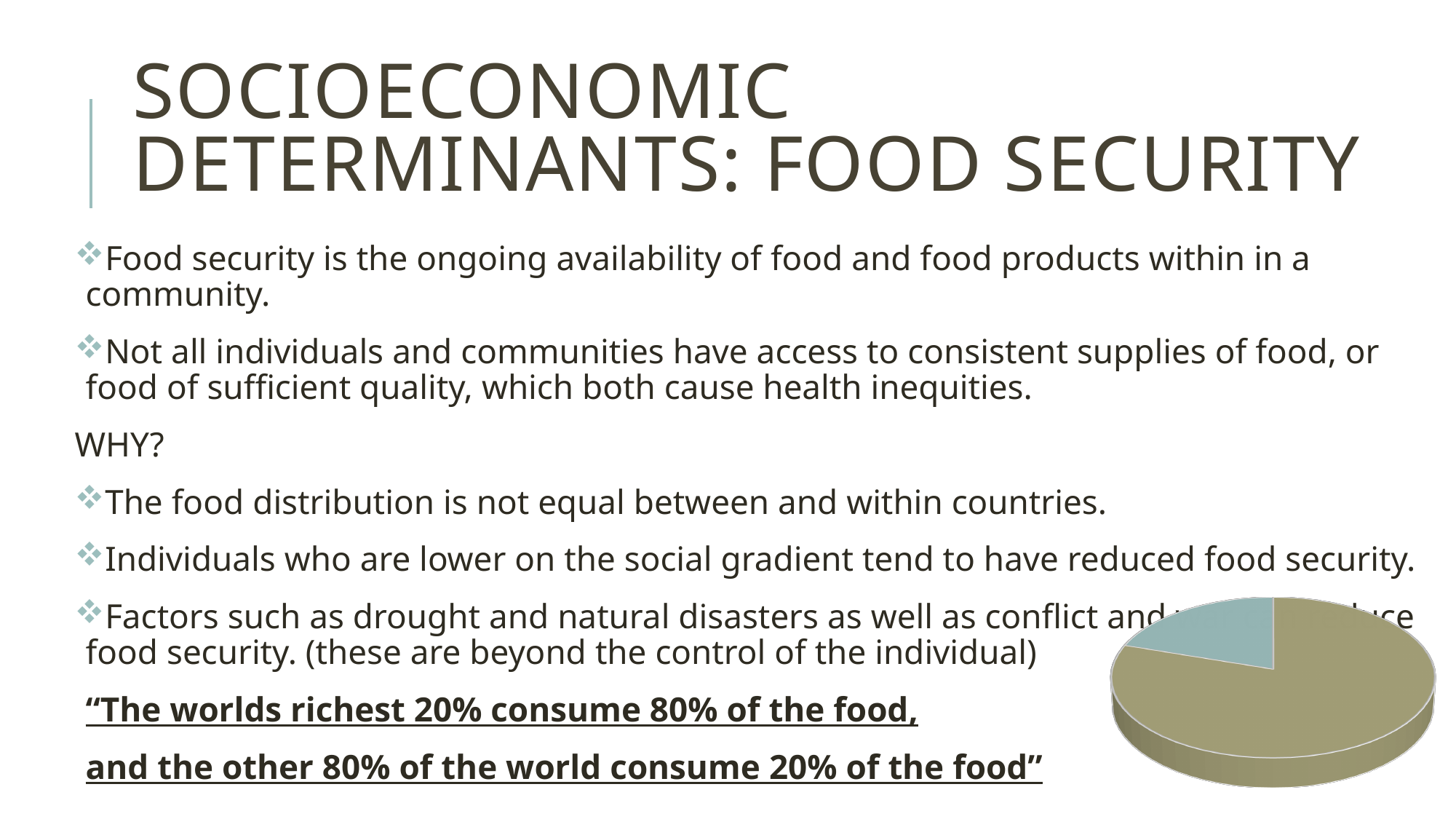
Which slice of the pie chart is the smallest? the blue-grey slice Does the pie chart display a legend? No Which slice of the pie chart is larger, the olive/khaki one or the blue-grey one? the olive/khaki one What kind of chart is shown on the slide? pie chart How many slices does the pie chart have? 2 Is the pie chart drawn in 3D or flat 2D? 3D